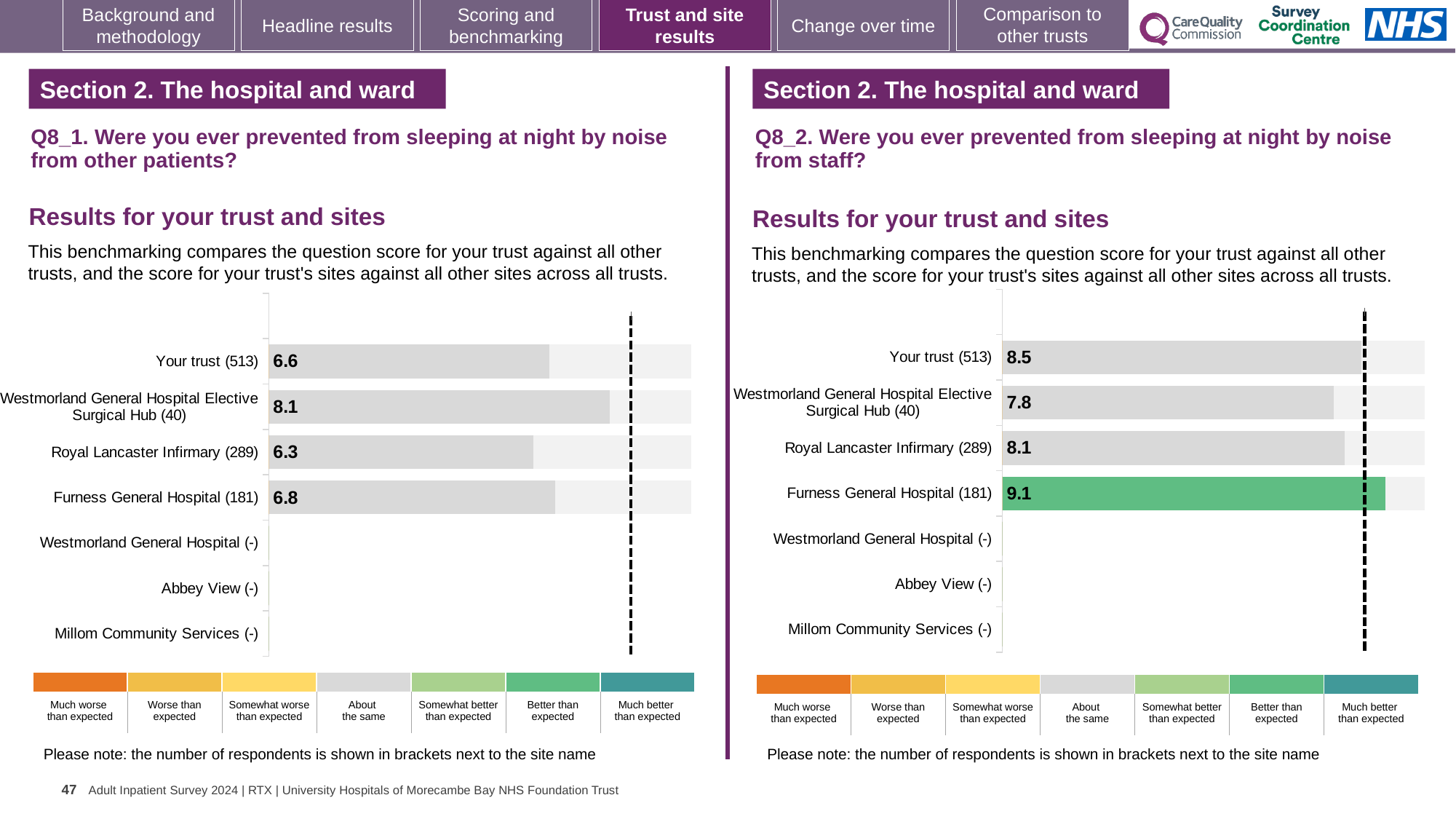
On the Q8_2 chart (noise from staff), what is the score for Westmorland General Hospital Elective Surgical Hub? 7.8 On the Q8_1 chart (noise from other patients), what is the difference between the scores for Furness General Hospital and Royal Lancaster Infirmary? 0.5 On the Q8_2 chart (noise from staff), which is larger: the score for Your trust or the score for Royal Lancaster Infirmary? Your trust On the Q8_2 chart (noise from staff), how many sites are listed with a score shown? 3 On the Q8_1 chart (noise from other patients), what is the score for Royal Lancaster Infirmary? 6.3 On the Q8_1 chart (noise from other patients), which site has the highest score? Westmorland General Hospital Elective Surgical Hub On the Q8_1 chart (noise from other patients), what is the score for Your trust? 6.6 What kind of chart is used on the Q8_1 chart (noise from other patients)? Bar chart On the Q8_1 chart (noise from other patients), which site has the lowest score? Royal Lancaster Infirmary On the Q8_2 chart (noise from staff), what is the difference between the scores for Furness General Hospital and Your trust? 0.6 On the Q8_2 chart (noise from staff), what is the score for Furness General Hospital? 9.1 On the Q8_2 chart (noise from staff), which site has the highest score? Furness General Hospital